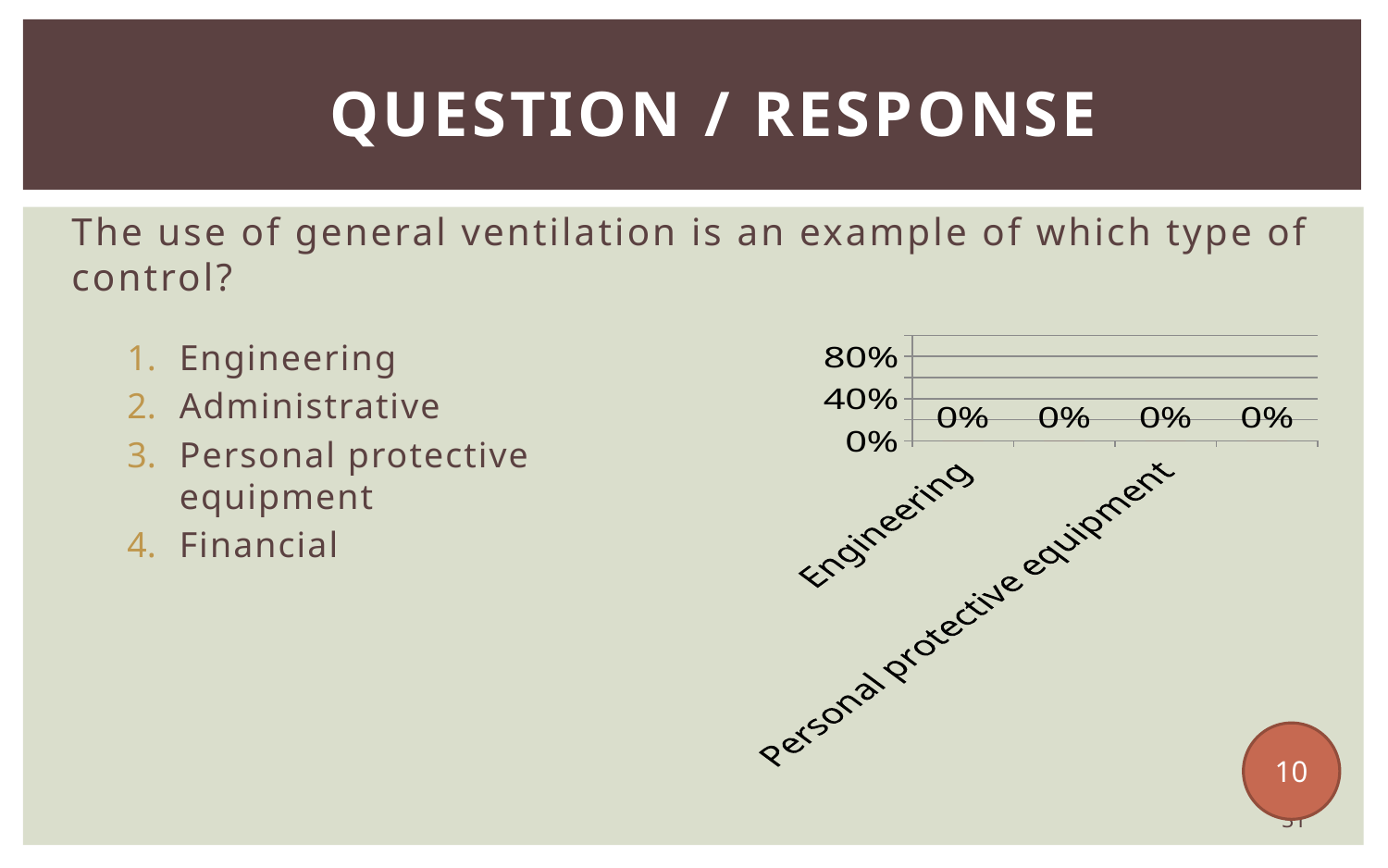
How many data labels are shown on the chart? 4 What is the value shown for Engineering? 0% What is the highest value labelled on the vertical axis? 80% Is the value for Engineering greater or less than 40%? less What is the value shown for Personal protective equipment? 0% What is the difference between the values for Engineering and Personal protective equipment? 0% Is the value for Personal protective equipment greater or less than 80%? less What is the lowest value labelled on the vertical axis? 0%